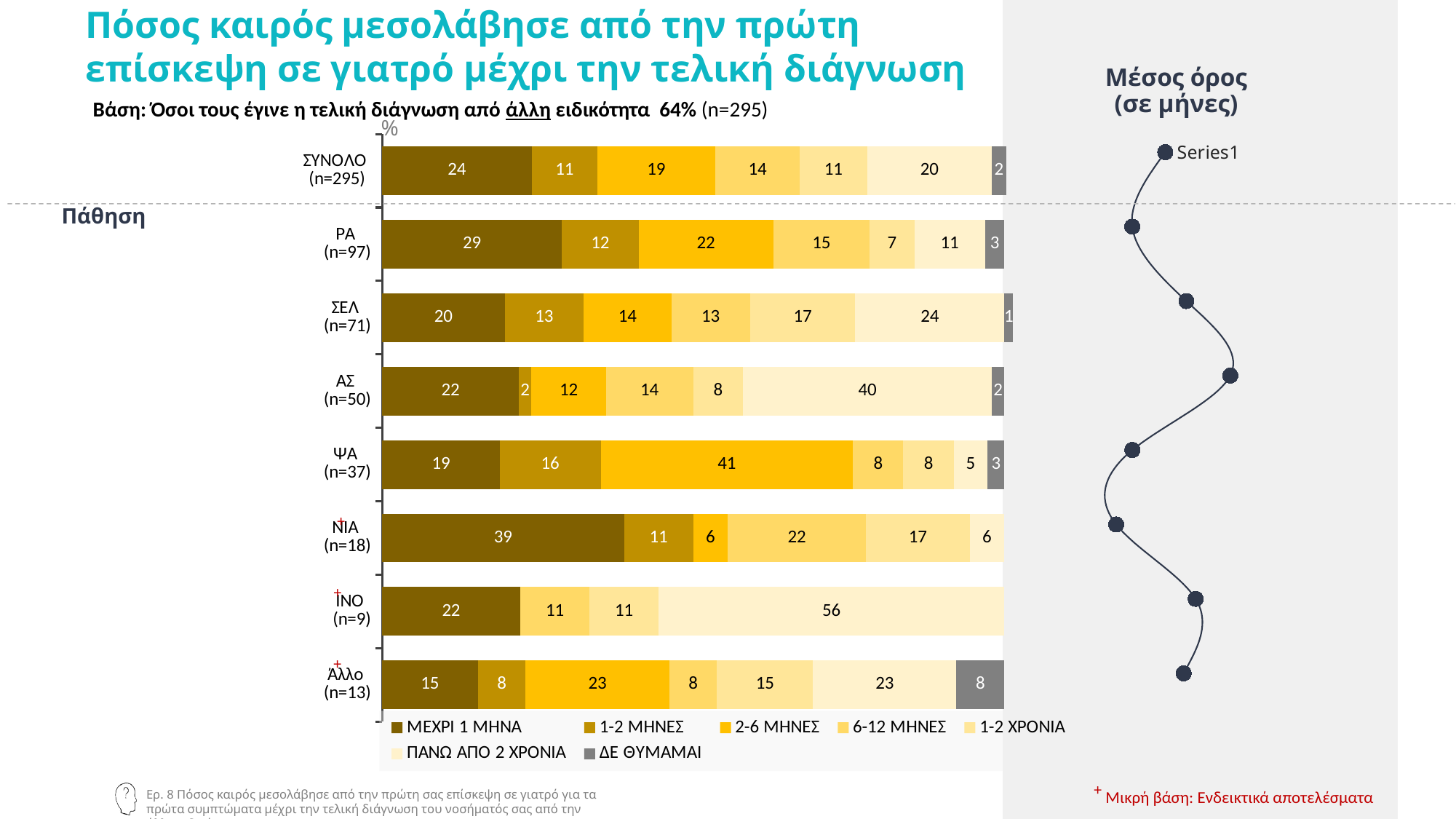
In the stacked bar chart, which category has the lowest value for ΜΕΧΡΙ 1 ΜΗΝΑ? Άλλο (n=13) In the stacked bar chart, what is the value of ΔΕ ΘΥΜΑΜΑΙ for Άλλο (n=13)? 8 In the stacked bar chart, what is the difference between the ΜΕΧΡΙ 1 ΜΗΝΑ values for ΡΑ and ΣΕΛ? 9 What kind of chart is the main chart on the left of the slide? Stacked bar chart In the stacked bar chart, what is the value of ΜΕΧΡΙ 1 ΜΗΝΑ for ΡΑ (n=97)? 29 How many categories (rows) are shown in the stacked bar chart? 8 In the stacked bar chart, what is the value of 2-6 ΜΗΝΕΣ for ΨΑ (n=37)? 41 How many series does the legend of the stacked bar chart list? 7 In the stacked bar chart, what is the value of ΠΑΝΩ ΑΠΟ 2 ΧΡΟΝΙΑ for ΑΣ (n=50)? 40 What is the title of the chart on the right side of the slide? Μέσος όρος (σε μήνες) In the stacked bar chart, which has the larger 2-6 ΜΗΝΕΣ value, ΡΑ or ΣΕΛ? ΡΑ In the stacked bar chart, which category has the highest value for ΜΕΧΡΙ 1 ΜΗΝΑ? ΝΙΑ (n=18)